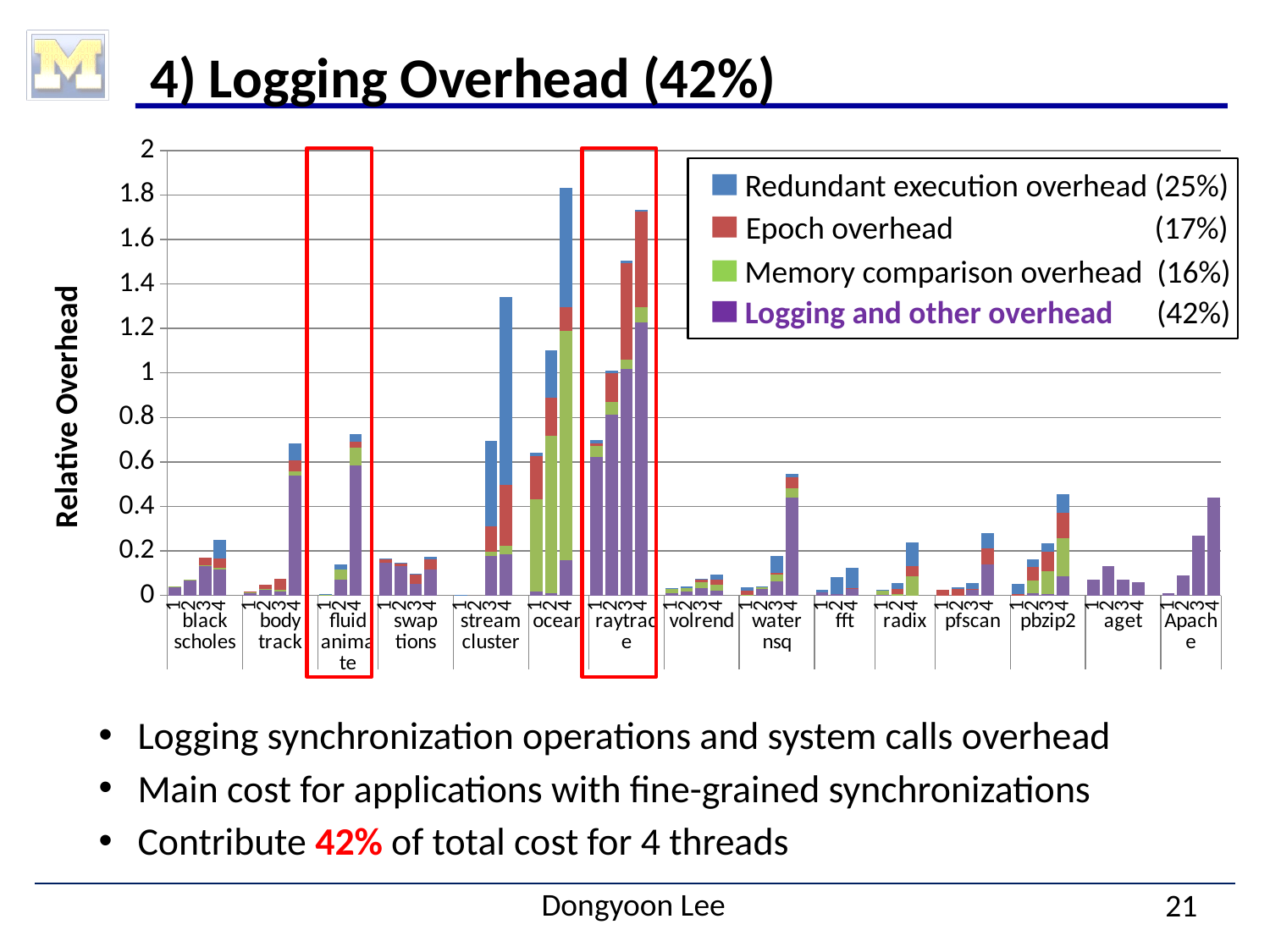
Which legend entry has the smallest percentage shown next to it? Memory comparison overhead (16%) Do the stacked bars for raytrace rise or fall as the thread count goes from 1 to 4? rise How many application groups are shown along the x axis? 15 What kind of chart is shown on the slide? stacked bar chart What percentage is shown next to "Epoch overhead" in the legend? 17% Is the total relative overhead for raytrace with 4 threads greater or less than 1.6? greater Is the total relative overhead for fft with 4 threads greater or less than 0.2? less Which legend entry has the largest percentage shown next to it? Logging and other overhead (42%) How many series does the legend list? 4 Is the total relative overhead for ocean with 4 threads greater or less than 1.6? greater What is the title of the y axis? Relative Overhead Which two application groups are outlined with red boxes on the chart? fluidanimate and raytrace